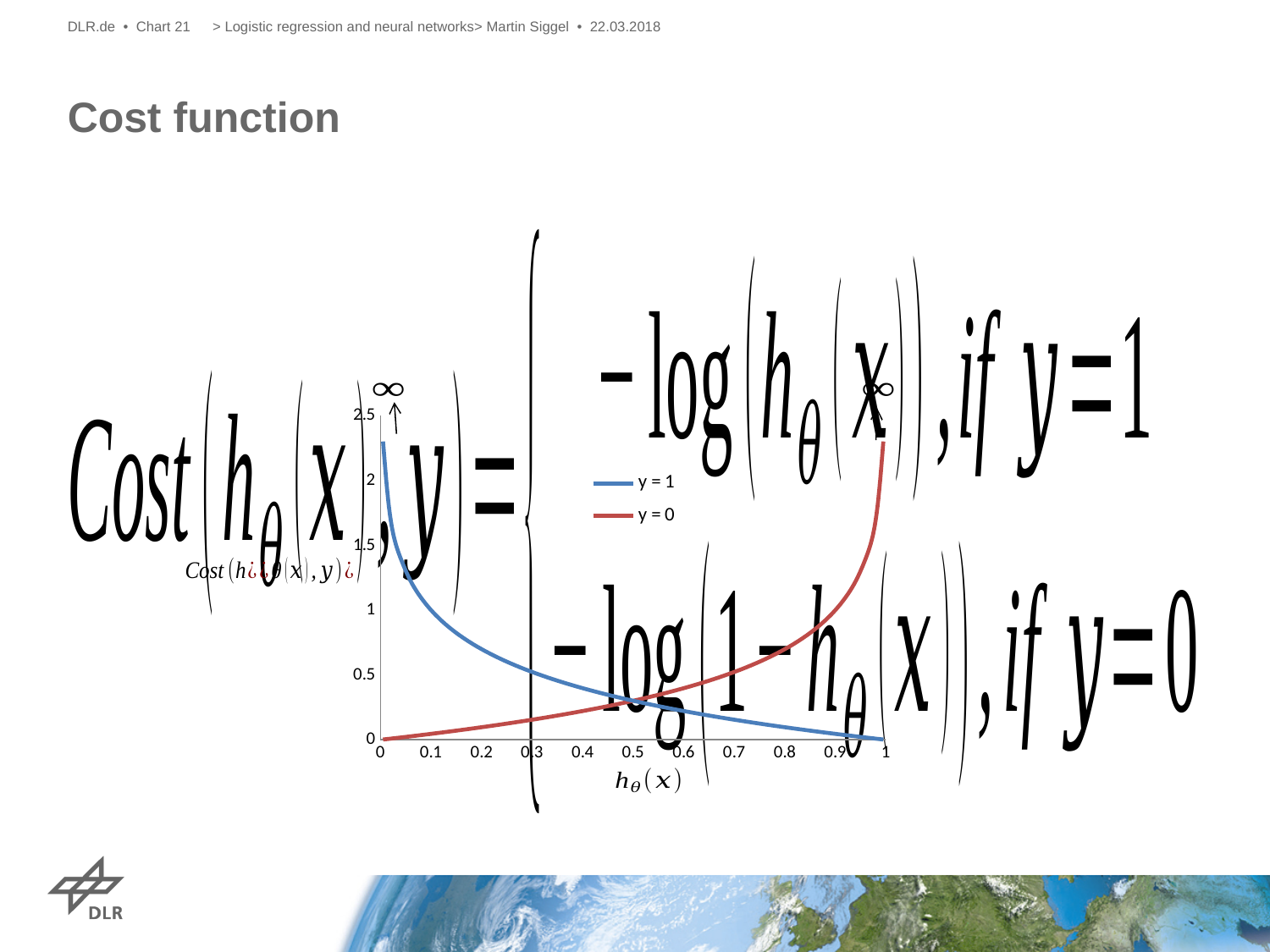
At h_θ(x) = 0.1, which series has the larger value, y = 1 or y = 0? y = 1 What are the two series named in the chart legend? y = 1 and y = 0 Does the y = 0 curve rise or fall as h_θ(x) increases from 0 to 1? rise Which colour is used for the y = 0 series in the chart? red How many series does the chart legend list? 2 What kind of chart is shown on the slide? line chart At h_θ(x) = 0.9, which series has the larger value, y = 1 or y = 0? y = 0 Is the value of the y = 0 curve at h_θ(x) = 0.2 greater or less than 0.5? less Is the value of the y = 0 curve at h_θ(x) = 0.9 greater or less than 2? less What is the highest tick value shown on the chart's vertical axis? 2.5 Does the y = 1 curve rise or fall as h_θ(x) increases from 0 to 1? fall Is the value of the y = 1 curve at h_θ(x) = 0.8 greater or less than 0.5? less